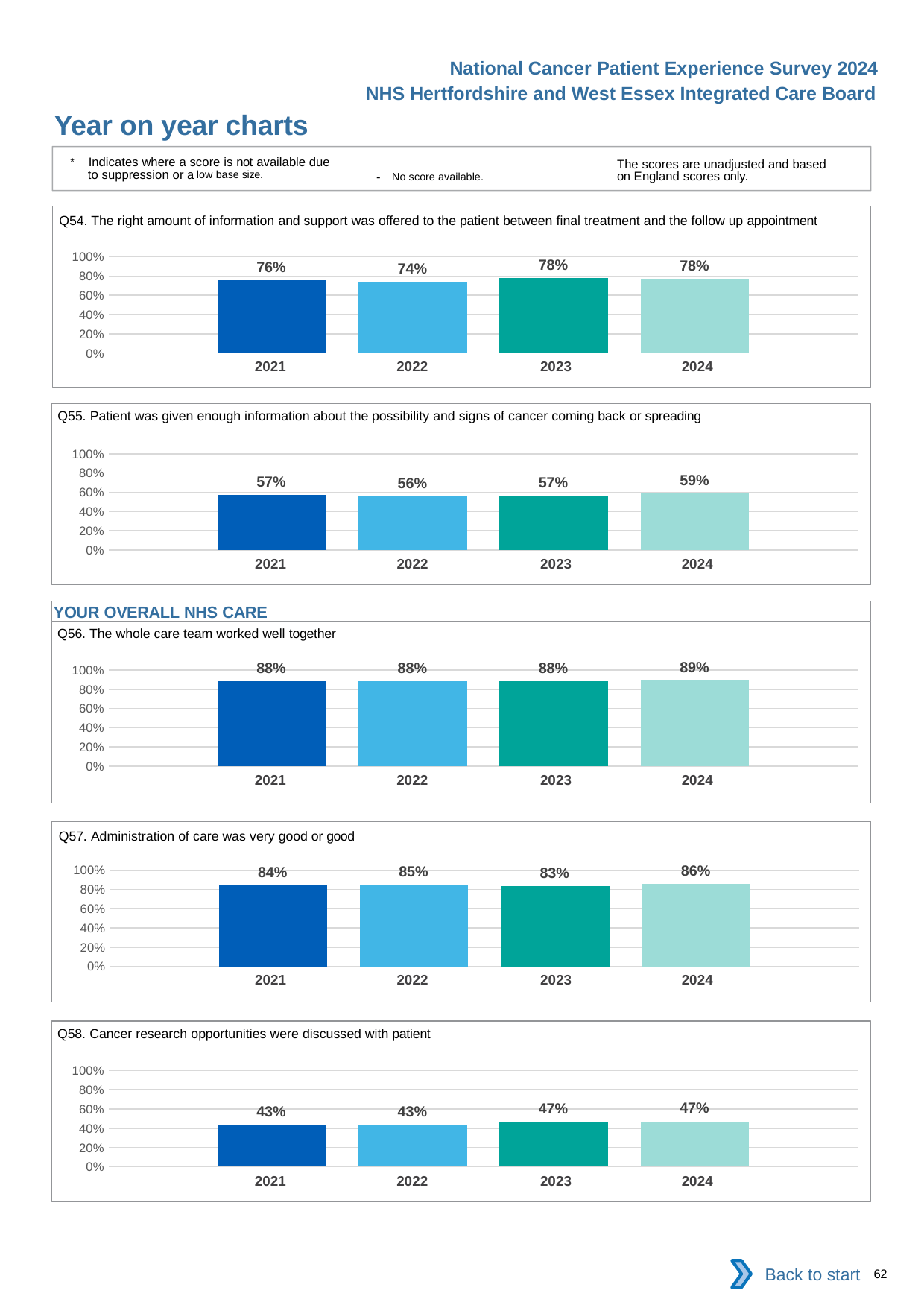
In the Q57 chart, which year has the lowest value? 2023 What kind of chart is the Q58 chart? bar chart In the Q58 chart, what is the value for 2021? 43% In the Q55 chart, which year has the highest value? 2024 In the Q56 chart, what is the value for 2024? 89% How many years are shown in the Q56 chart? 4 In the Q58 chart, is the value for 2024 greater or less than 60%? less In the Q58 chart, is the value for 2023 larger or smaller than the value for 2022? larger In the Q55 chart, which year has the lowest value? 2022 In the Q54 chart, what is the difference between the 2023 value and the 2022 value? 4% In the Q54 chart, what is the value for 2022? 74% In the Q57 chart, what is the difference between the 2024 value and the 2023 value? 3%